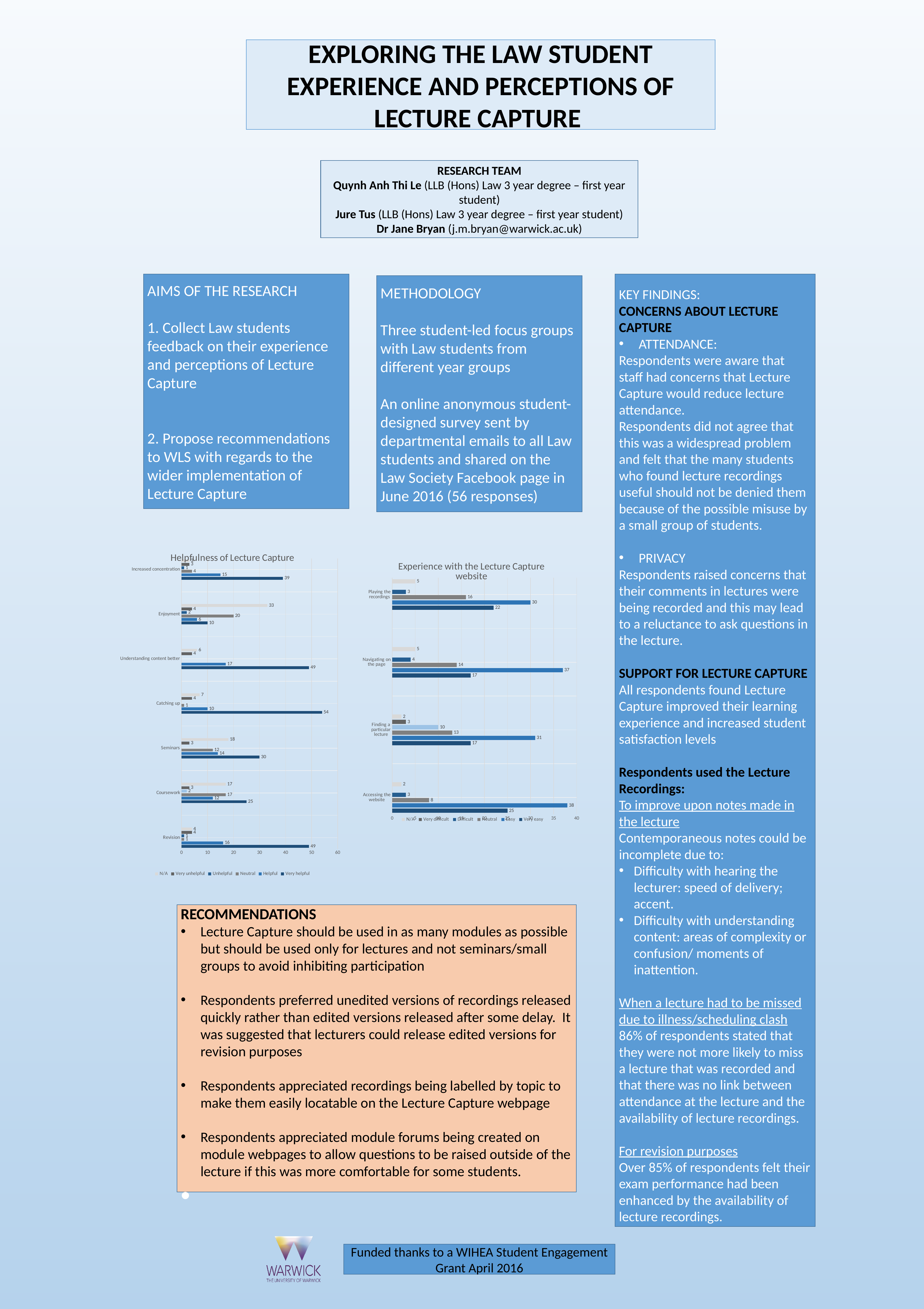
In the "Experience with the Lecture Capture website" chart, what is the Easy value for Accessing the website? 38 In the "Helpfulness of Lecture Capture" chart, what is the difference between the Very helpful values for Catching up and Seminars? 24 How many categories are shown on the "Helpfulness of Lecture Capture" chart? 7 In the "Helpfulness of Lecture Capture" chart, which category has the highest Very helpful value? Catching up How many series does the legend of the "Helpfulness of Lecture Capture" chart list? 6 What type of chart is the "Helpfulness of Lecture Capture" chart? bar chart In the "Helpfulness of Lecture Capture" chart, is the Very helpful value for Coursework or for Revision larger? Revision In the "Experience with the Lecture Capture website" chart, which category has the highest Easy value? Accessing the website How many categories are shown on the "Experience with the Lecture Capture website" chart? 4 In the "Helpfulness of Lecture Capture" chart, what is the Very helpful value for Catching up? 54 In the "Helpfulness of Lecture Capture" chart, what is the Very helpful value for Understanding content better? 49 What type of chart is the "Experience with the Lecture Capture website" chart? bar chart